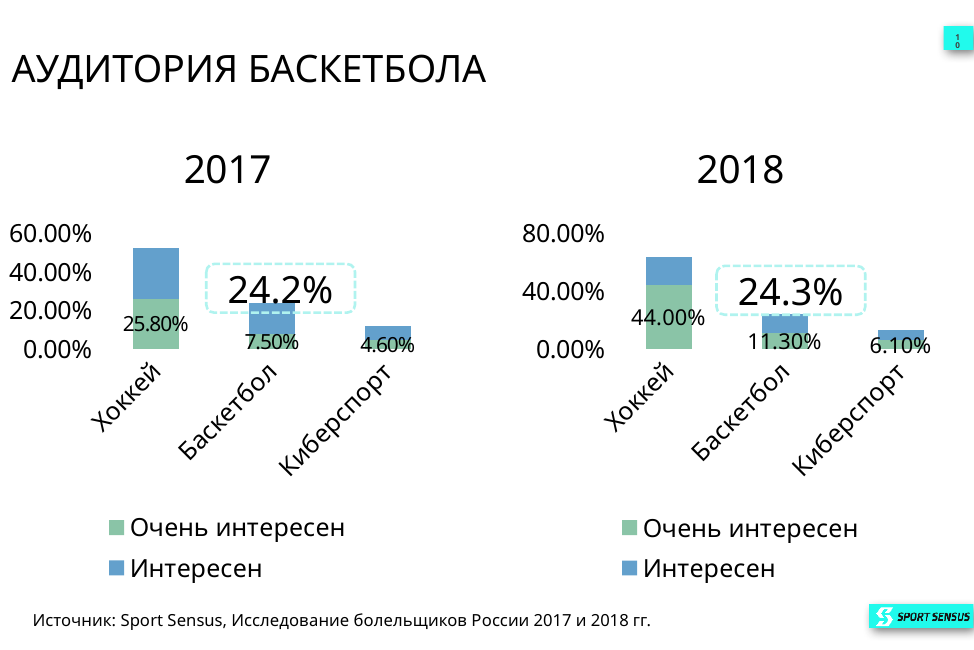
In the 2017 chart, what value is labelled on the Хоккей bar? 25.80% In the 2018 chart, what is the difference between the labelled values for Хоккей and Баскетбол? 32.70% In the 2018 chart, what value is labelled on the Баскетбол bar? 11.30% How many categories are shown on the x axis of the 2018 chart? 3 What type of chart is used for the 2017 and 2018 charts on this slide? Stacked bar chart In the 2017 chart, which labelled value is larger: Баскетбол or Киберспорт? Баскетбол (7.50%) How many series does the legend of the 2017 chart list? 2 What value is shown in the dashed callout box above the Баскетбол bar in the 2018 chart? 24.3% In the 2017 chart, which category has the tallest bar? Хоккей In the 2018 chart, which category has the shortest bar? Киберспорт In the 2017 chart, is the total height of the Хоккей bar greater or less than 40.00%? greater In the 2018 chart, what value is labelled on the Киберспорт bar? 6.10%